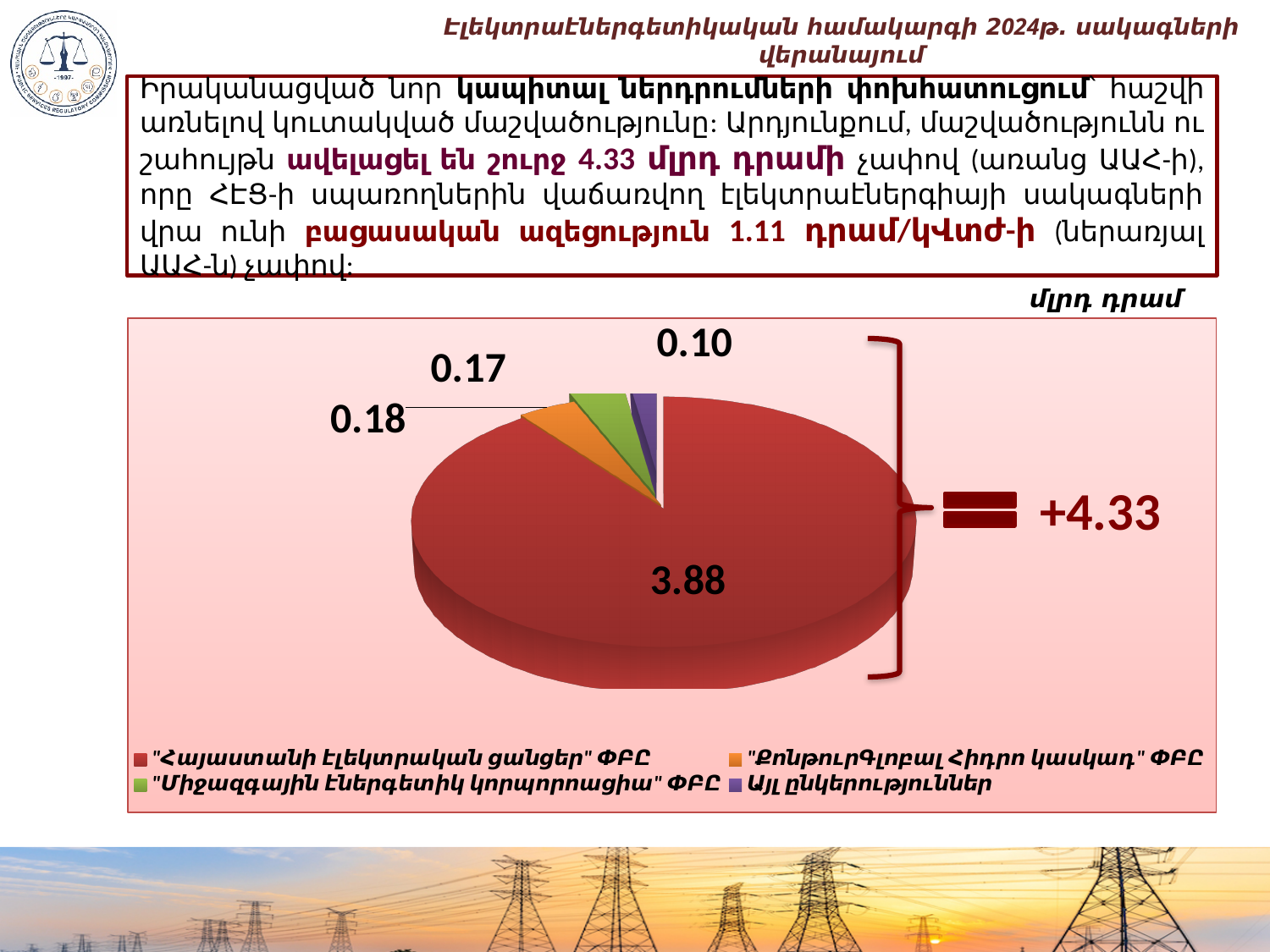
What is the value of the slice for "Հայաստանի էլեկտրական ցանցեր" ՓԲԸ? 3.88 What unit is indicated above the pie chart? մլրդ դրամ What kind of chart is shown on the slide? Pie chart What is the value of the slice for "ՔոնթուրԳլոբալ Հիդրո կասկադ" ՓԲԸ? 0.18 What is the total of all slices shown next to the pie chart? +4.33 How many entries does the legend of the pie chart list? 4 What is the difference between the values for "Հայաստանի էլեկտրական ցանցեր" ՓԲԸ and "ՔոնթուրԳլոբալ Հիդրո կասկադ" ՓԲԸ? 3.70 Which category has the largest slice in the pie chart? "Հայաստանի էլեկտրական ցանցեր" ՓԲԸ What is the value of the slice for Այլ ընկերություններ? 0.10 What is the value of the slice for "Միջազգային էներգետիկ կորպորացիա" ՓԲԸ? 0.17 Which category has the smallest slice in the pie chart? Այլ ընկերություններ How many slices does the pie chart have? 4